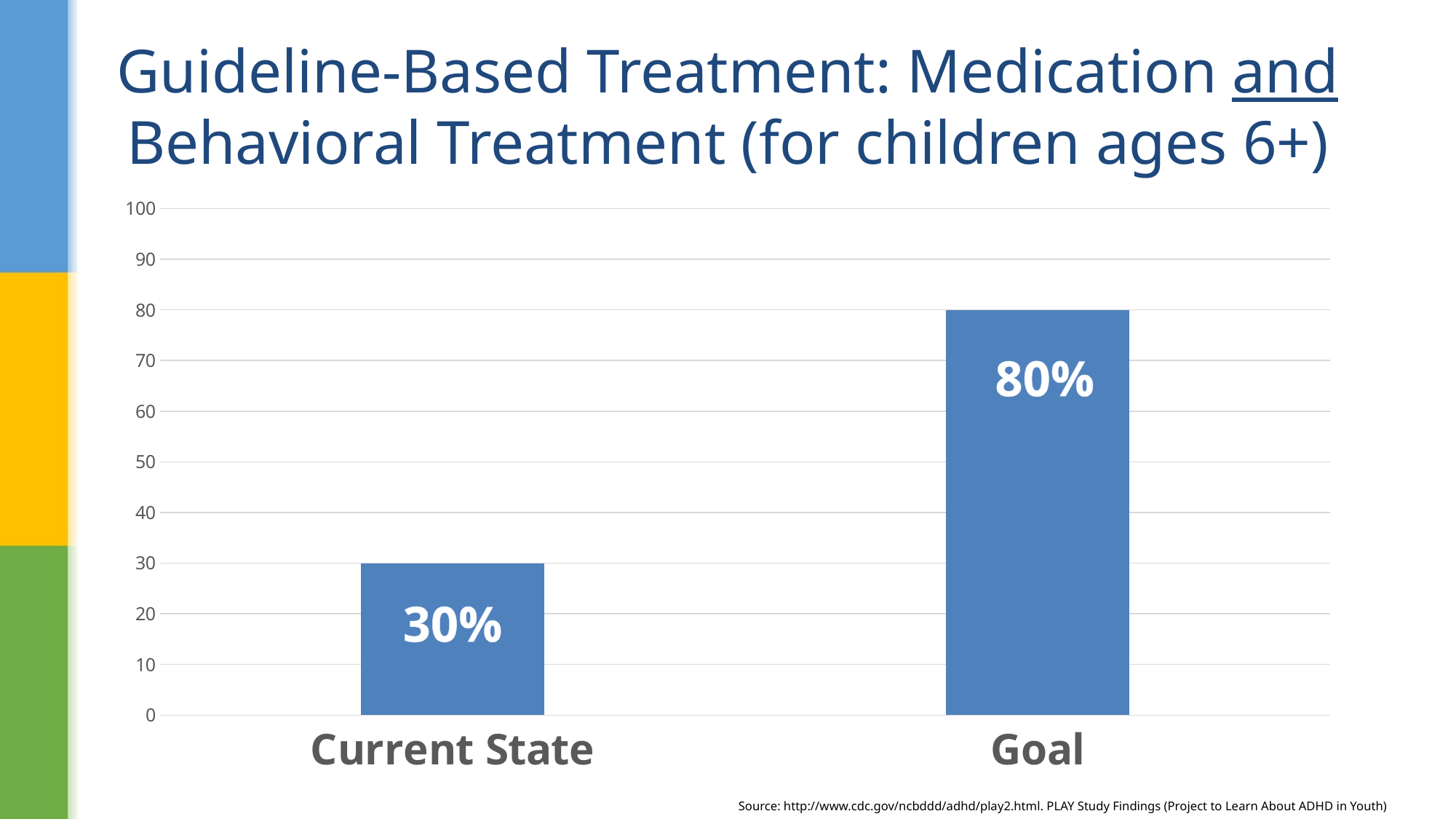
What is the value for Goal? 80% What is the maximum value shown on the y axis? 100 What is the value for Current State? 30% Is the value for Goal greater or less than 70? greater Which category has the highest value? Goal Which category has the lowest value? Current State Which is larger, the value for Current State or the value for Goal? Goal How many categories are shown on the x axis? 2 What is the difference between the Goal value and the Current State value? 50% What kind of chart is shown on the slide? bar chart Is the value for Current State greater or less than 50? less Do the values rise or fall from Current State to Goal? rise